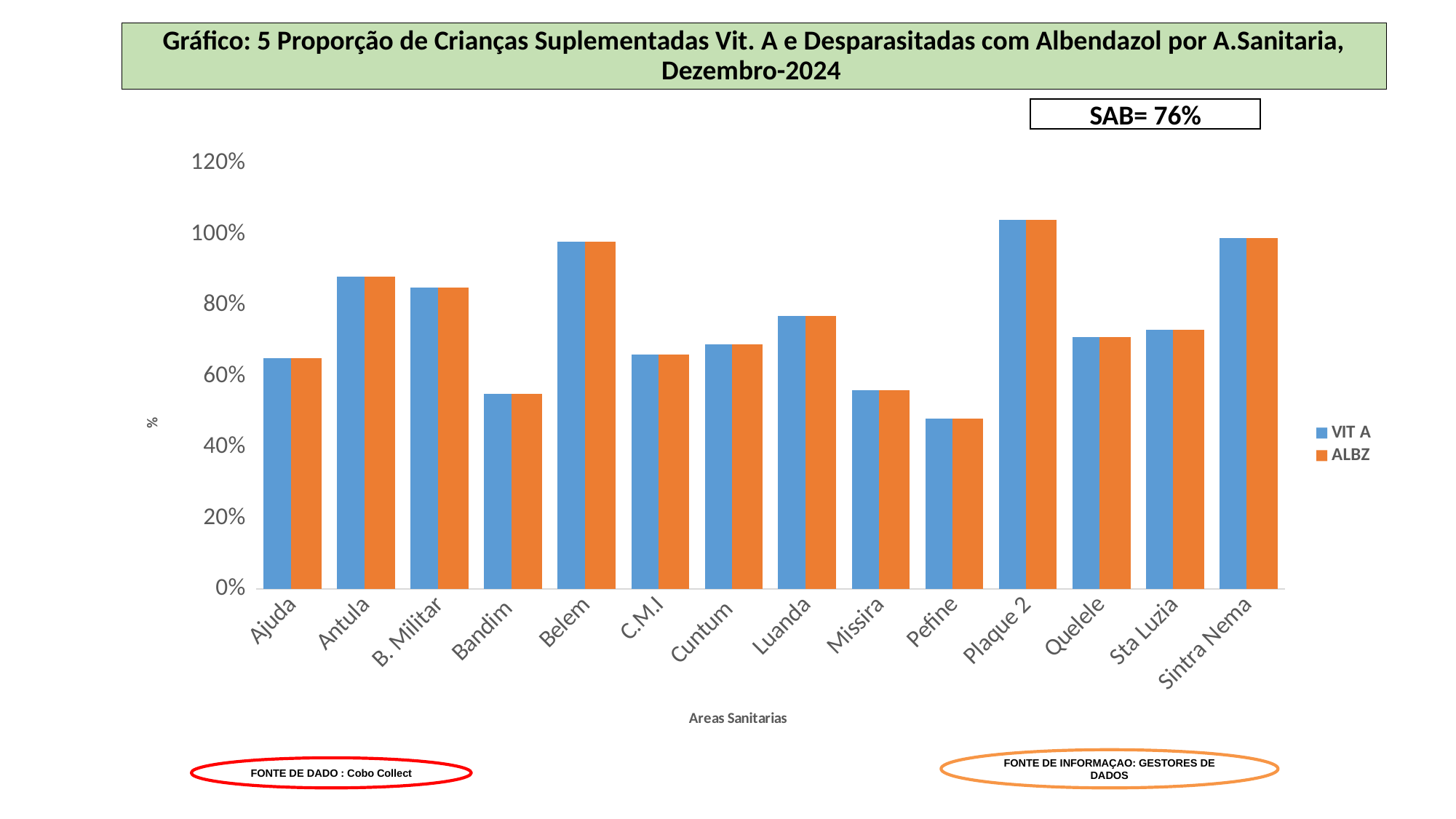
Which health area has the lowest ALBZ value? Pefine Is the ALBZ value for Bandim greater or less than 60%? less Which health area has the highest VIT A value? Plaque 2 How many health areas (categories) are shown on the x axis? 14 Is the VIT A value for Plaque 2 greater or less than 100%? greater What kind of chart is shown on the slide? bar chart Which has the larger ALBZ value, Ajuda or Antula? Antula Which has the larger VIT A value, Belem or Luanda? Belem Is the VIT A value for Antula greater or less than 80%? greater How many series does the legend list? 2 What SAB value is shown in the box above the chart? SAB= 76%